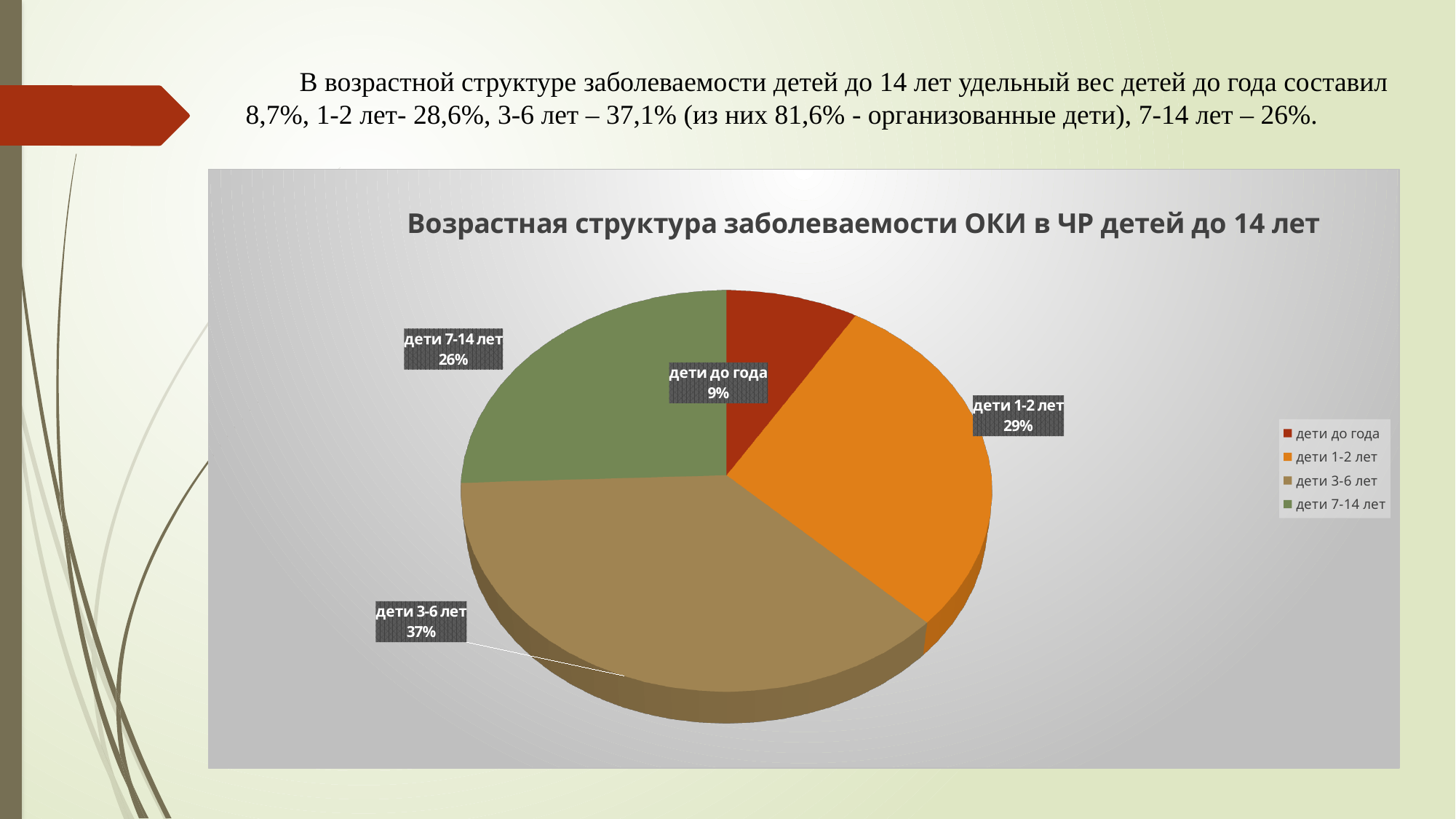
Which age group has the largest slice of the pie? дети 3-6 лет What is the title of the chart? Возрастная структура заболеваемости ОКИ в ЧР детей до 14 лет How many slices does the pie chart have? 4 Which age group has the smallest slice of the pie? дети до года How many entries does the legend list? 4 What share of the pie does the slice 'дети 7-14 лет' represent? 26% Which slice is larger: 'дети 1-2 лет' or 'дети 7-14 лет'? дети 1-2 лет What share of the pie does the slice 'дети 1-2 лет' represent? 29% What share of the pie does the slice 'дети до года' represent? 9% What type of chart is shown on the slide? Pie chart What is the difference in percentage points between the 'дети 3-6 лет' slice and the 'дети до года' slice? 28%